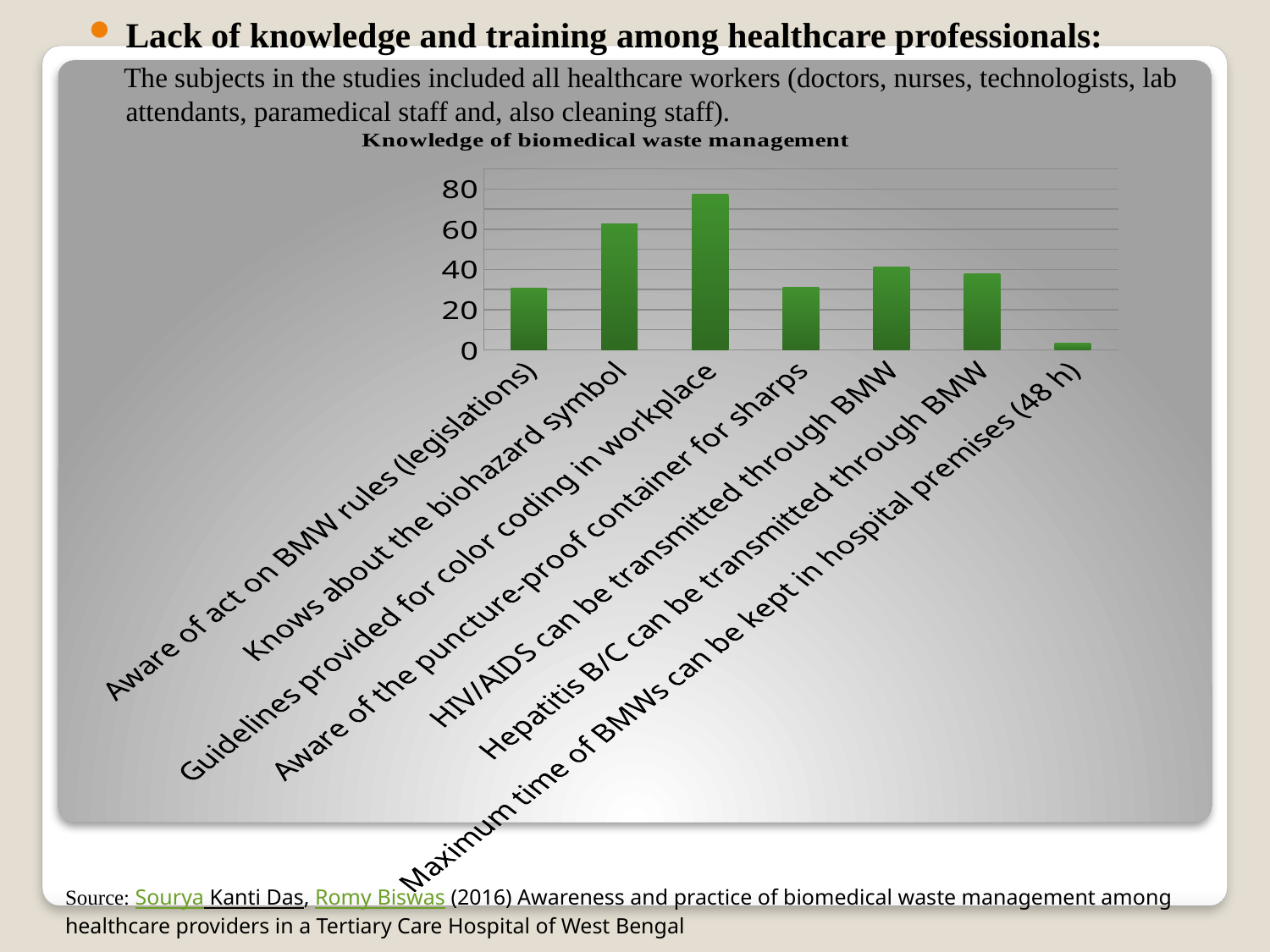
Is the value for 'HIV/AIDS can be transmitted through BMW' greater or less than 20? greater What kind of chart is shown on the slide? Bar chart Which is larger: the value for 'Knows about the biohazard symbol' or the value for 'Aware of the puncture-proof container for sharps'? Knows about the biohazard symbol Is the value for 'Aware of act on BMW rules (legislations)' greater or less than 40? less Which category has the lowest value? Maximum time of BMWs can be kept in hospital premises (48 h) Is the value for 'Maximum time of BMWs can be kept in hospital premises (48 h)' greater or less than 20? less How many categories are plotted in the chart? 7 Which category has the highest value? Guidelines provided for color coding in workplace Which is larger: the value for 'Hepatitis B/C can be transmitted through BMW' or the value for 'Maximum time of BMWs can be kept in hospital premises (48 h)'? Hepatitis B/C can be transmitted through BMW What is the title of the chart? Knowledge of biomedical waste management